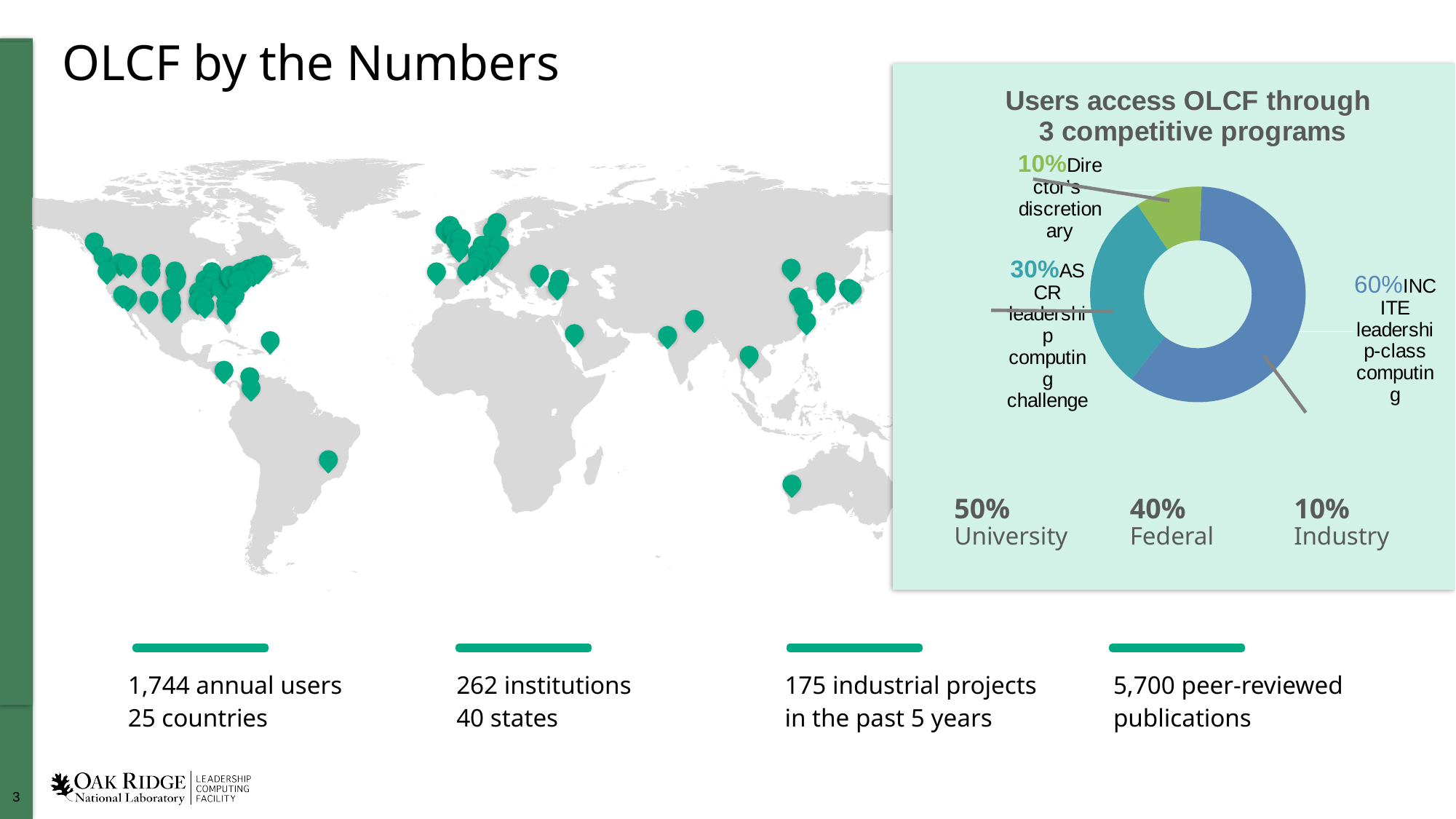
What kind of chart is used to show how users access OLCF? Doughnut chart Which is larger in the pie chart: the ASCR leadership computing challenge share or the Director's discretionary share? ASCR leadership computing challenge What percentage does the Director's discretionary program account for in the pie chart? 10% By how many percentage points does the INCITE share exceed the Director's discretionary share? 50 percentage points How many programs (slices) are shown in the pie chart? 3 Which program has the smallest slice of the pie chart? Director's discretionary What is the title of the chart on the slide? Users access OLCF through 3 competitive programs What share of the pie chart is the ASCR leadership computing challenge? 30% What percentage of users access OLCF through the INCITE leadership-class computing program? 60% Which program has the largest slice of the pie chart? INCITE leadership-class computing By how many percentage points does the INCITE share exceed the ASCR leadership computing challenge share? 30 percentage points What colour is the INCITE leadership-class computing slice in the pie chart? Blue